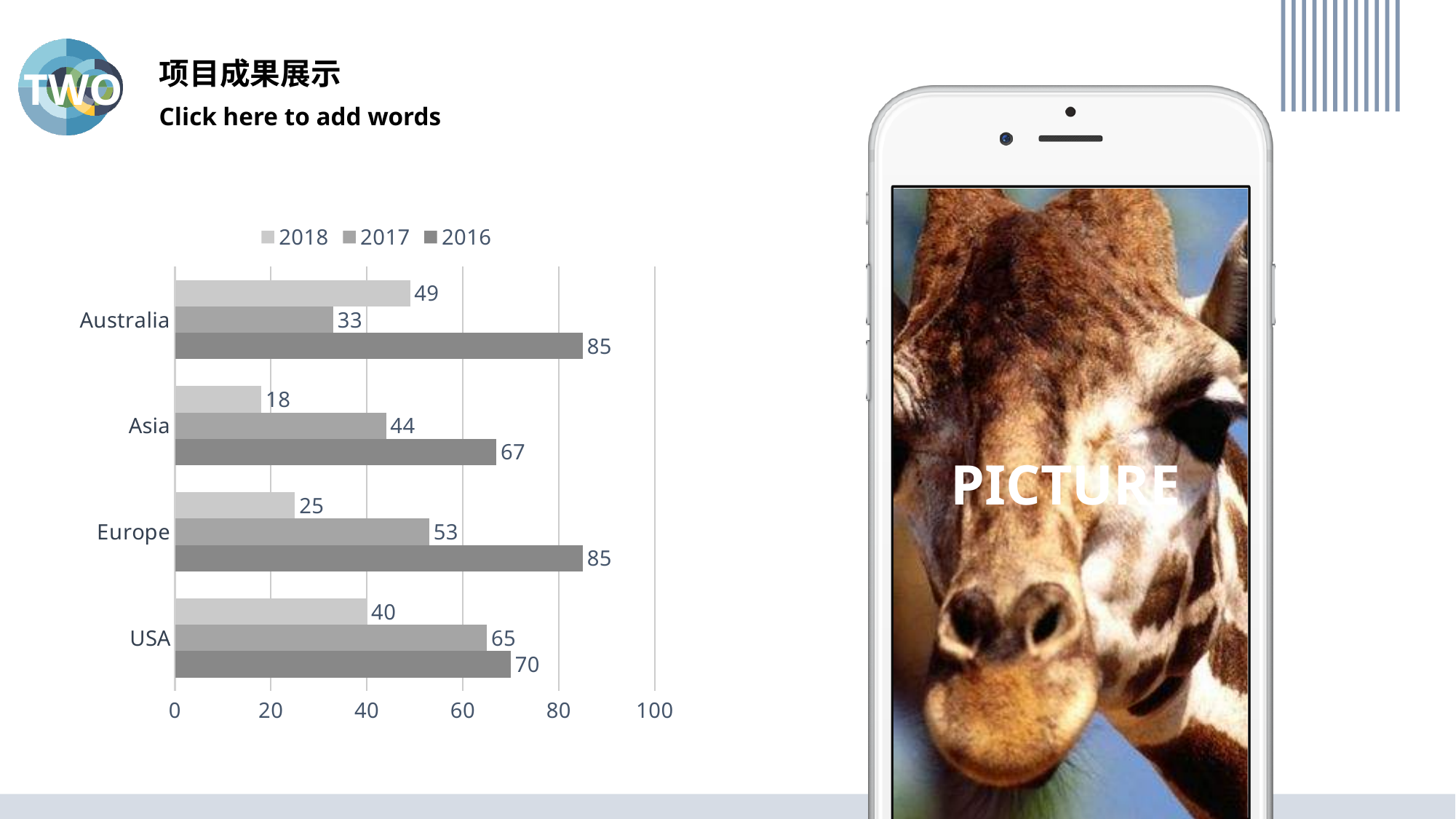
How many series does the legend list? 3 Which category has the lowest 2018 value? Asia What is the difference between the 2016 and 2017 values for Australia? 52 What kind of chart is shown on the slide? bar chart What is the 2017 value for Europe? 53 How many categories are shown on the chart? 4 What is the 2016 value for Asia? 67 Which category has the highest 2018 value? Australia Which series is listed first in the legend? 2018 What is the 2018 value for USA? 40 Which is larger for USA, the 2017 value or the 2016 value? 2016 Which category has the highest 2017 value? USA